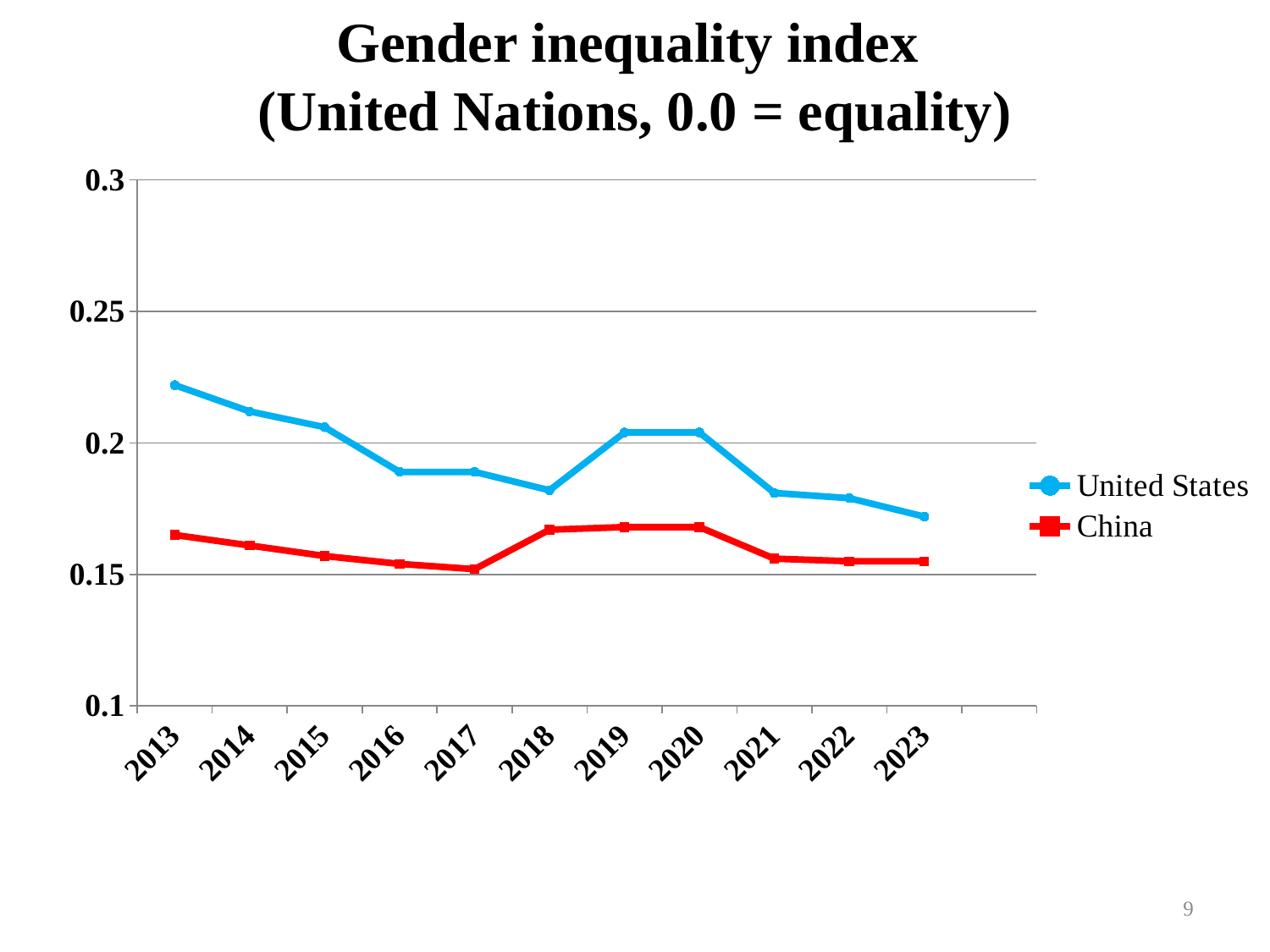
Is the value for the United States in 2023 greater or less than 0.2? less Which series has the higher value in 2020, United States or China? United States Is the value for the United States in 2013 greater or less than 0.2? greater Is the value for China in 2013 greater or less than 0.15? greater What kind of chart is shown on the slide? line chart Which colour is used for the China series? red Does the United States line overall rise or fall from 2013 to 2023? fall In which year is the United States value lowest? 2023 How many years are plotted along the x axis? 11 In which year is the China value lowest? 2017 How many series does the legend list? 2 In which year is the United States value highest? 2013